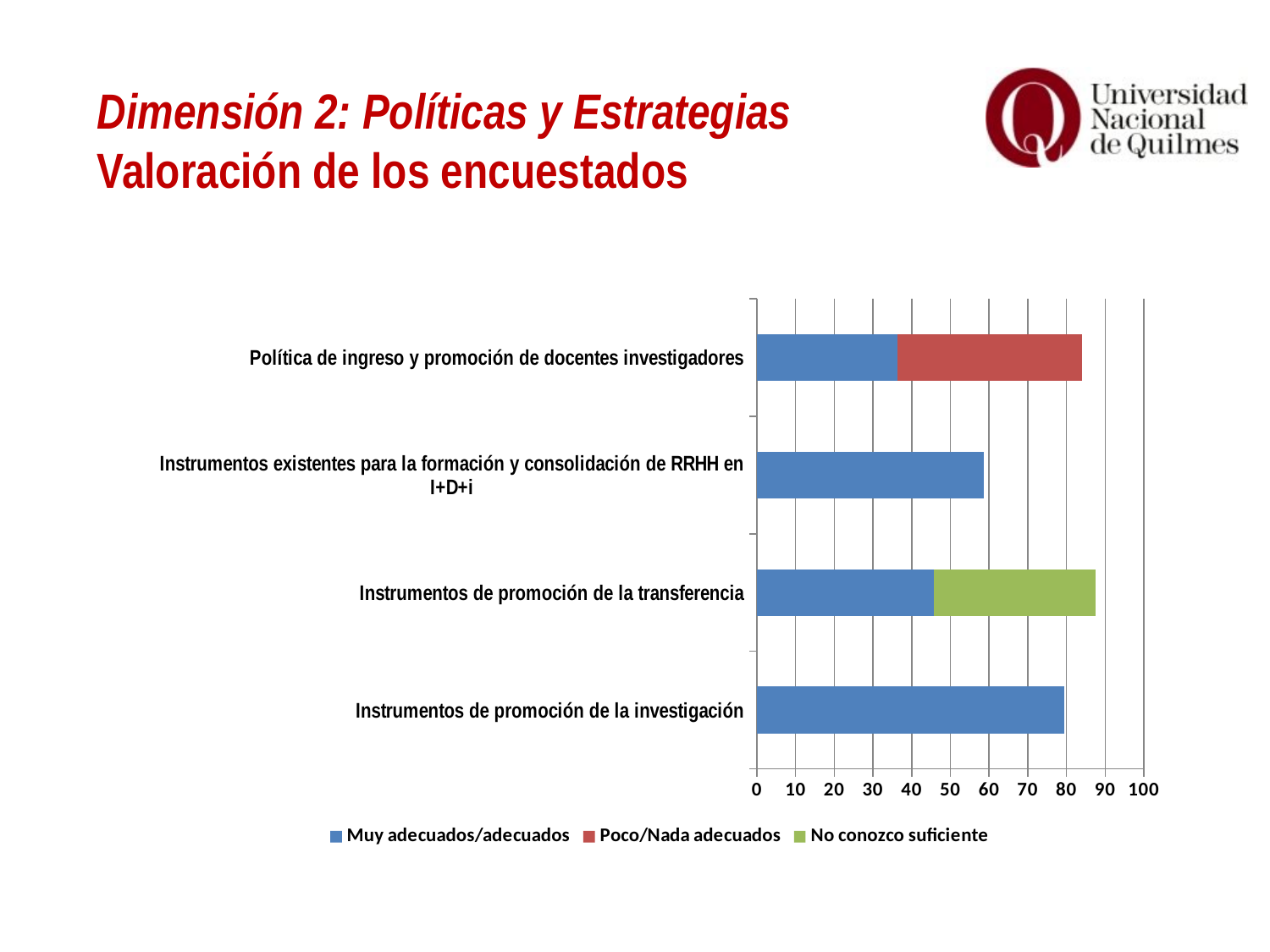
Which category has the highest value for Muy adecuados/adecuados? Instrumentos de promoción de la investigación Is the Muy adecuados/adecuados value for Instrumentos de promoción de la transferencia greater or less than 40? greater Which category is the only one with a No conozco suficiente segment? Instrumentos de promoción de la transferencia What colour represents Poco/Nada adecuados in the legend? Red How many categories are shown on the chart? 4 How many series does the legend list? 3 Is the Muy adecuados/adecuados value for Política de ingreso y promoción de docentes investigadores greater or less than 30? greater What kind of chart is shown on the slide? Bar chart Is the Muy adecuados/adecuados value for Instrumentos de promoción de la investigación greater or less than 70? greater Which is larger for Muy adecuados/adecuados: Instrumentos existentes para la formación y consolidación de RRHH en I+D+i or Instrumentos de promoción de la transferencia? Instrumentos existentes para la formación y consolidación de RRHH en I+D+i Which category has the lowest value for Muy adecuados/adecuados? Política de ingreso y promoción de docentes investigadores